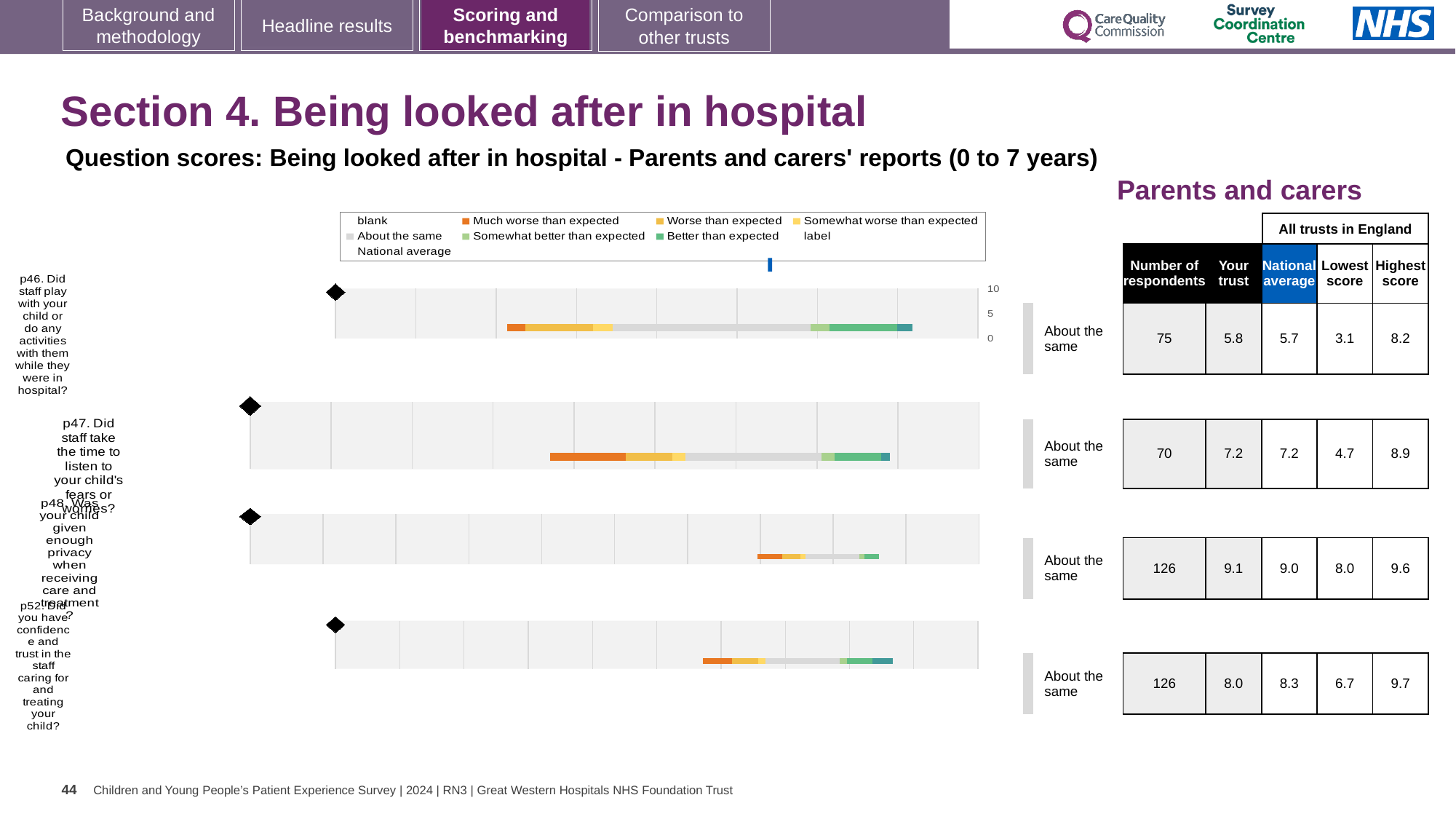
Which legend entry is shown in orange? Much worse than expected What kind of chart is used to show the question scores on this slide? bar chart What is the difference between the highest score (8.9) and the lowest score (4.7) across all trusts for p47? 4.2 Which question has the highest 'Your trust' score? p48 What is the 'Your trust' score for p46 (Did staff play with your child or do any activities with them while they were in hospital?)? 5.8 Which question has the lowest 'Your trust' score? p46 What is the lowest score across all trusts in England for p48 (Was your child given enough privacy when receiving care and treatment?)? 8.0 How many respondents answered p47 (Did staff take the time to listen to your child's fears or worries?)? 70 How many survey questions (p46, p47, p48, p52) are plotted as bars on the slide? 4 For p52, which is larger: the 'Your trust' score or the national average? National average What is the national average score for p52 (Did you have confidence and trust in the staff caring for and treating your child?)? 8.3 How many entries does the chart legend list? 9